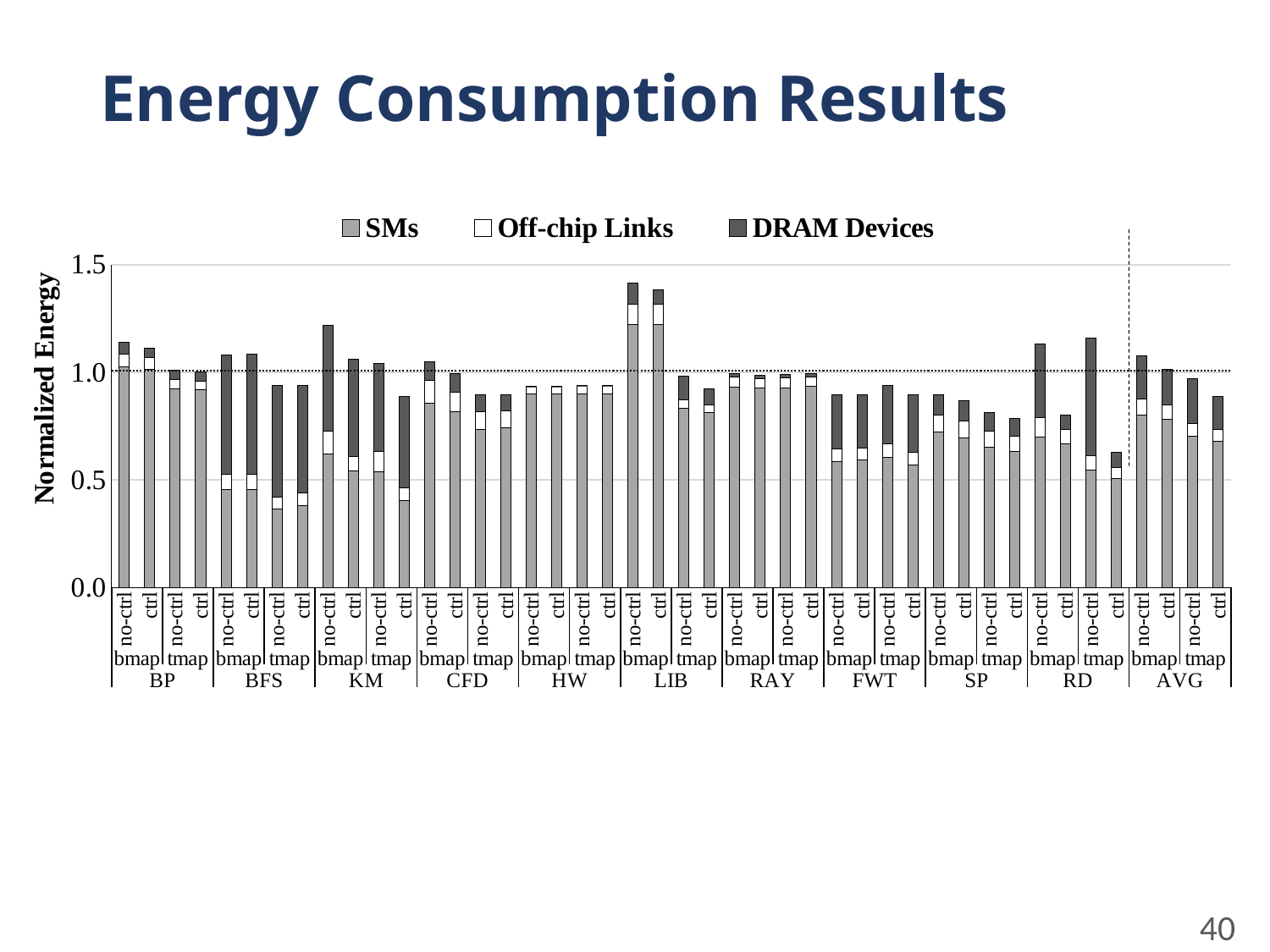
Which benchmark group contains the tallest bar in the chart? LIB What kind of chart is shown on the slide? Stacked bar chart How many series does the legend list? 3 Within the KM group, which bar is taller: bmap no-ctrl or tmap no-ctrl? bmap no-ctrl Which bar is the lowest in the chart? RD tmap ctrl Is the total value for the RD tmap ctrl bar greater or less than 1.0? less Is the total value for the AVG tmap ctrl bar greater or less than 1.0? less How many benchmark groups are labelled along the x axis (including AVG)? 11 Which bar is taller: LIB bmap no-ctrl or BP bmap no-ctrl? LIB bmap no-ctrl Is the total value for the LIB bmap no-ctrl bar greater or less than 1.0? greater What are the three series named in the legend? SMs, Off-chip Links, DRAM Devices What is the label of the y axis? Normalized Energy